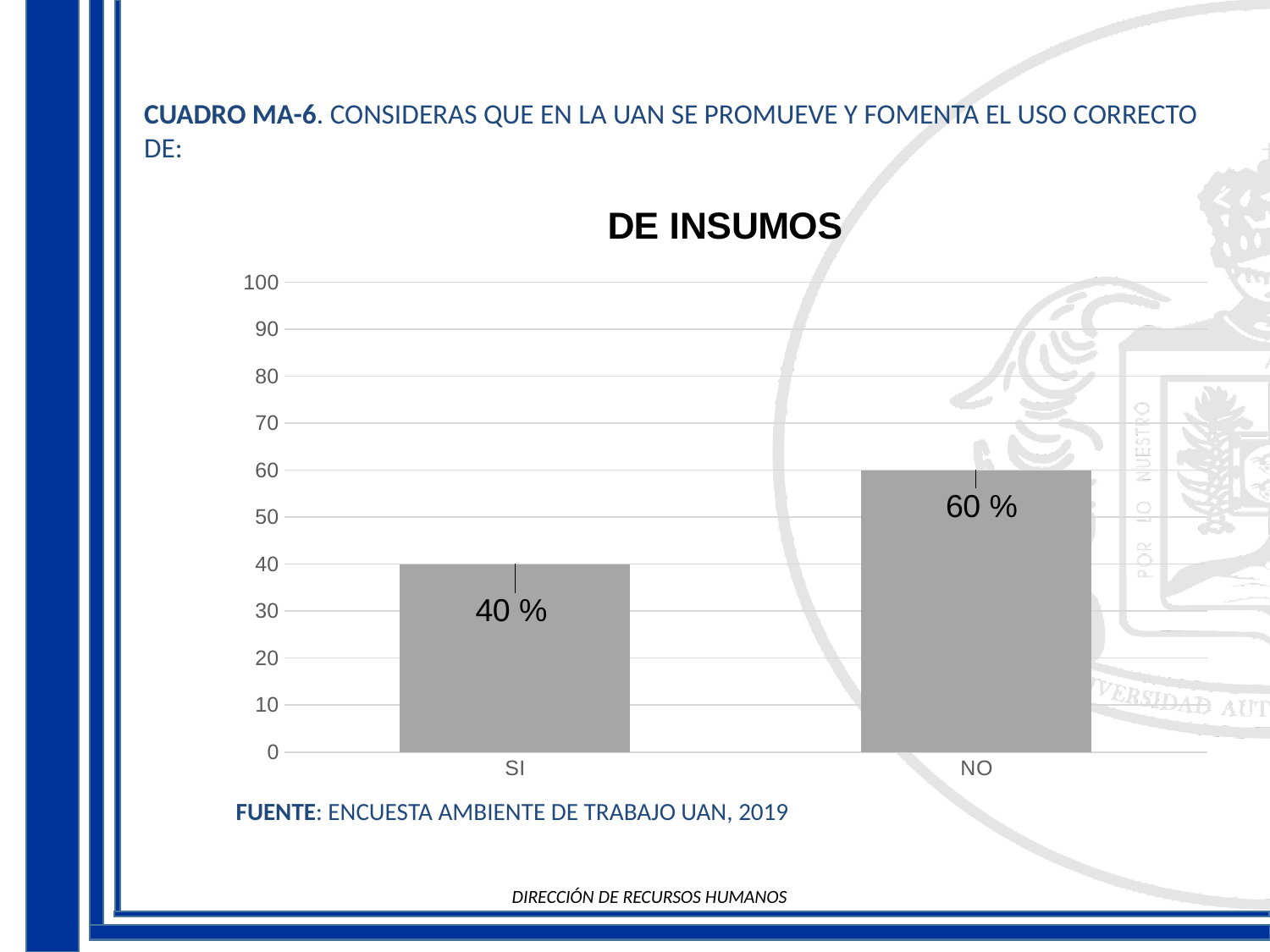
Which is larger, the value for SI or the value for NO? NO What is the value for SI? 40 % Is the value for NO greater or less than 50? greater Is the value for SI greater or less than 50? less What is the difference between the values for NO and SI? 20 % What is the value for NO? 60 % Which category has the lowest value? SI What kind of chart is shown? bar chart What is the title of the chart? DE INSUMOS How many categories are shown on the x axis? 2 What is the highest value shown on the y axis? 100 Which category has the highest value? NO